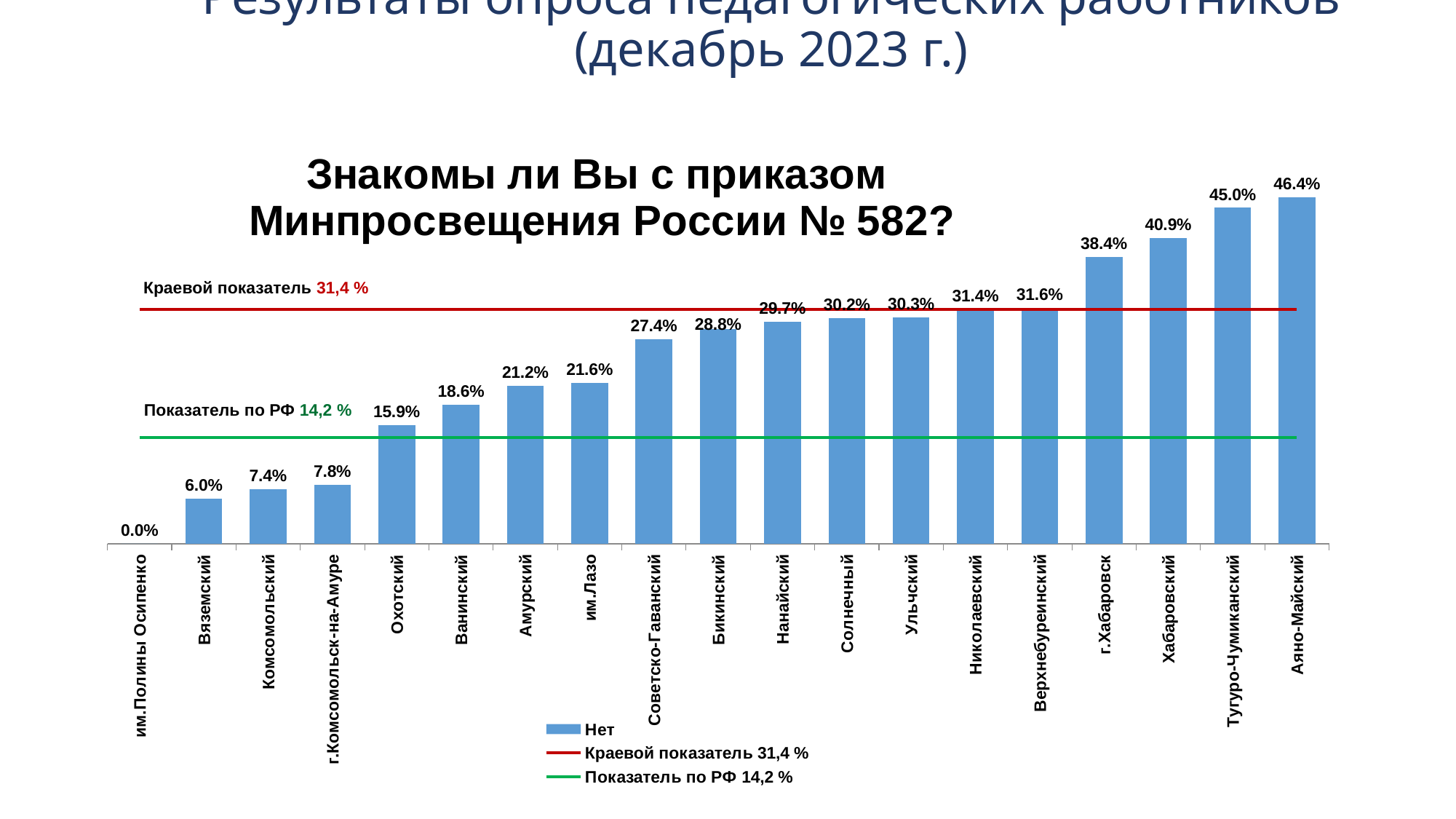
Which is larger, the value for Ванинский or the value for Амурский? Амурский Do the bar values rise or fall from left to right along the x axis? rise What is the value for Охотский? 15.9% How many categories are shown on the x axis? 19 What is the difference between the values for Хабаровский and г.Хабаровск? 2.5% Which category has the lowest value? им.Полины Осипенко What is the value for Советско-Гаванский? 27.4% How many entries does the legend list? 3 Which category has the highest value? Аяно-Майский What is the value for Аяно-Майский? 46.4% What value does the red horizontal line (Краевой показатель) represent? 31,4 % What kind of chart is this? bar chart